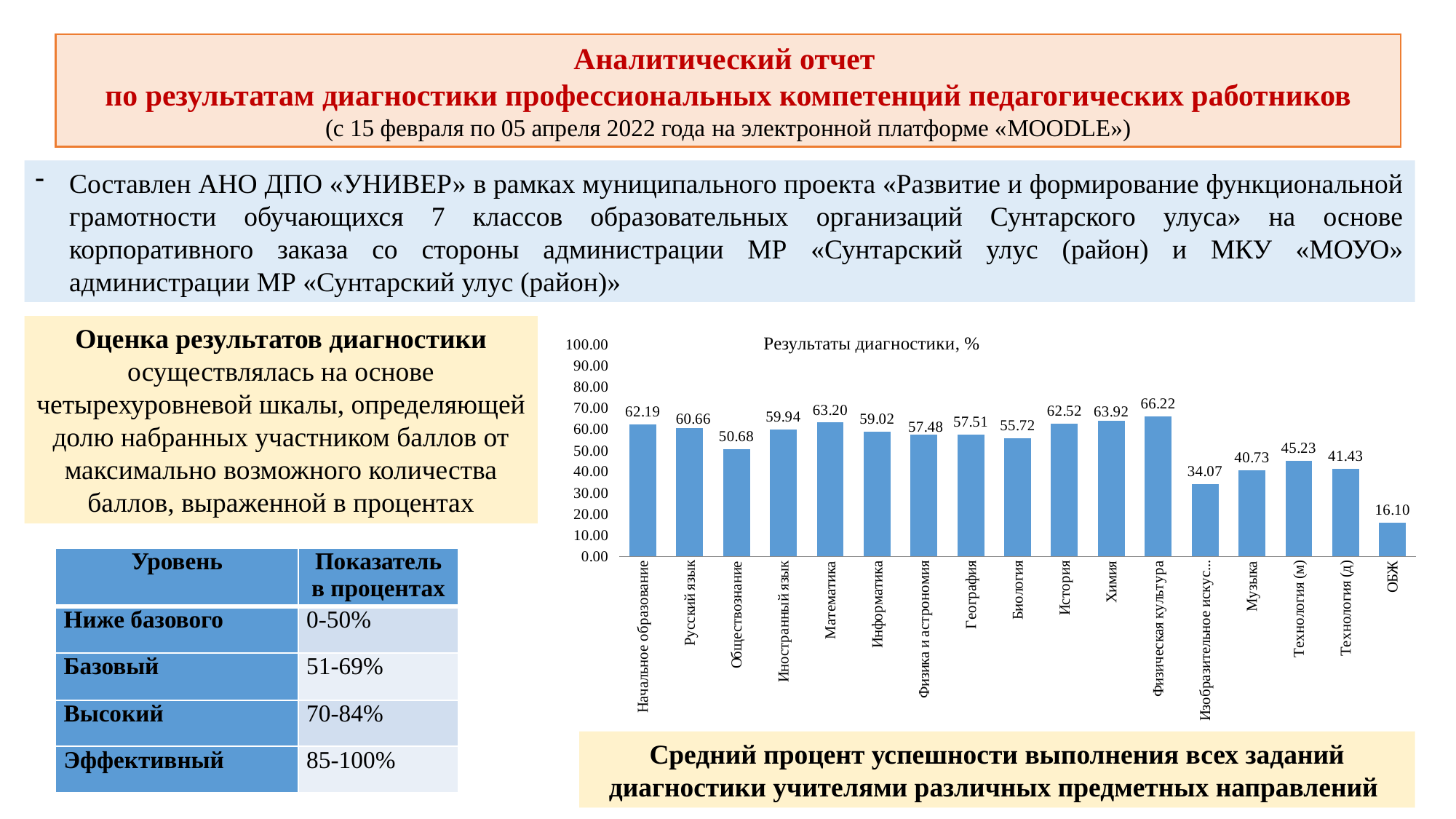
Which category has the lowest value in the chart? ОБЖ Which category has the highest value in the chart? Физическая культура What kind of chart is shown on the slide? bar chart What is the value for Обществознание in the chart? 50.68 What is the difference between the values for Физическая культура and ОБЖ? 50.12 Which is larger, the value for Музыка or the value for Технология (м)? Технология (м) What is the value for ОБЖ in the chart? 16.10 Is the value for Химия greater or less than 50.00? greater How many categories are shown in the chart? 17 What is the difference between the values for Русский язык and Иностранный язык? 0.72 What is the title of the chart? Результаты диагностики, % What is the value for Математика in the chart? 63.20